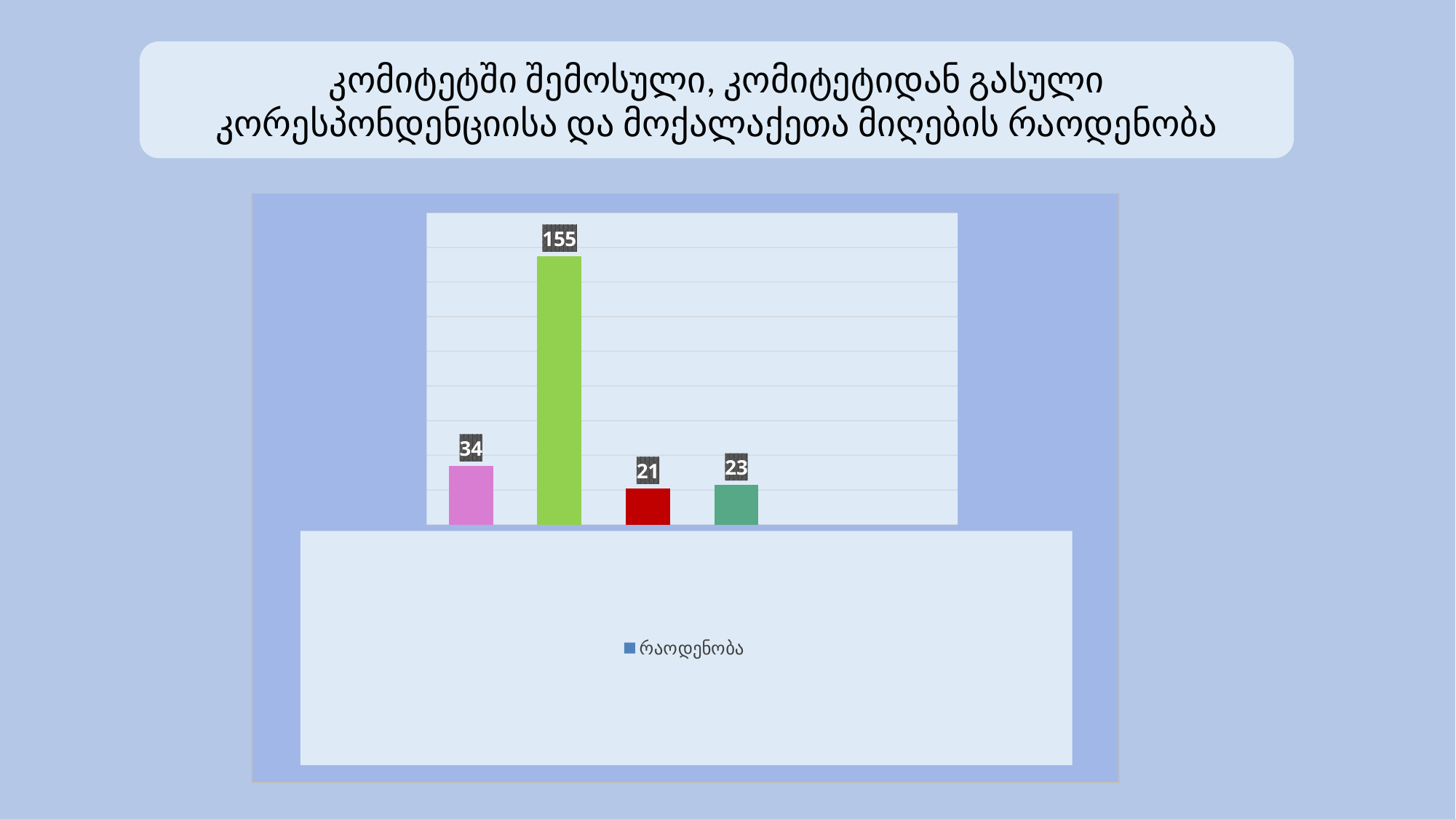
What is the value shown on the tallest (green) bar? 155 How many series does the chart legend list? 1 What is the value shown on the shortest (red) bar? 21 What type of chart is shown on the slide? bar chart What is the name of the series shown in the chart legend? რაოდენობა What is the difference between the green bar (155) and the pink bar (34)? 121 What is the value of the fourth (teal) bar from the left? 23 What colour is the bar with the value 155? green How many bars are plotted in the chart? 4 What is the value of the first (pink) bar from the left? 34 What is the difference between the teal bar (23) and the red bar (21)? 2 Which is larger, the pink bar or the teal bar? the pink bar